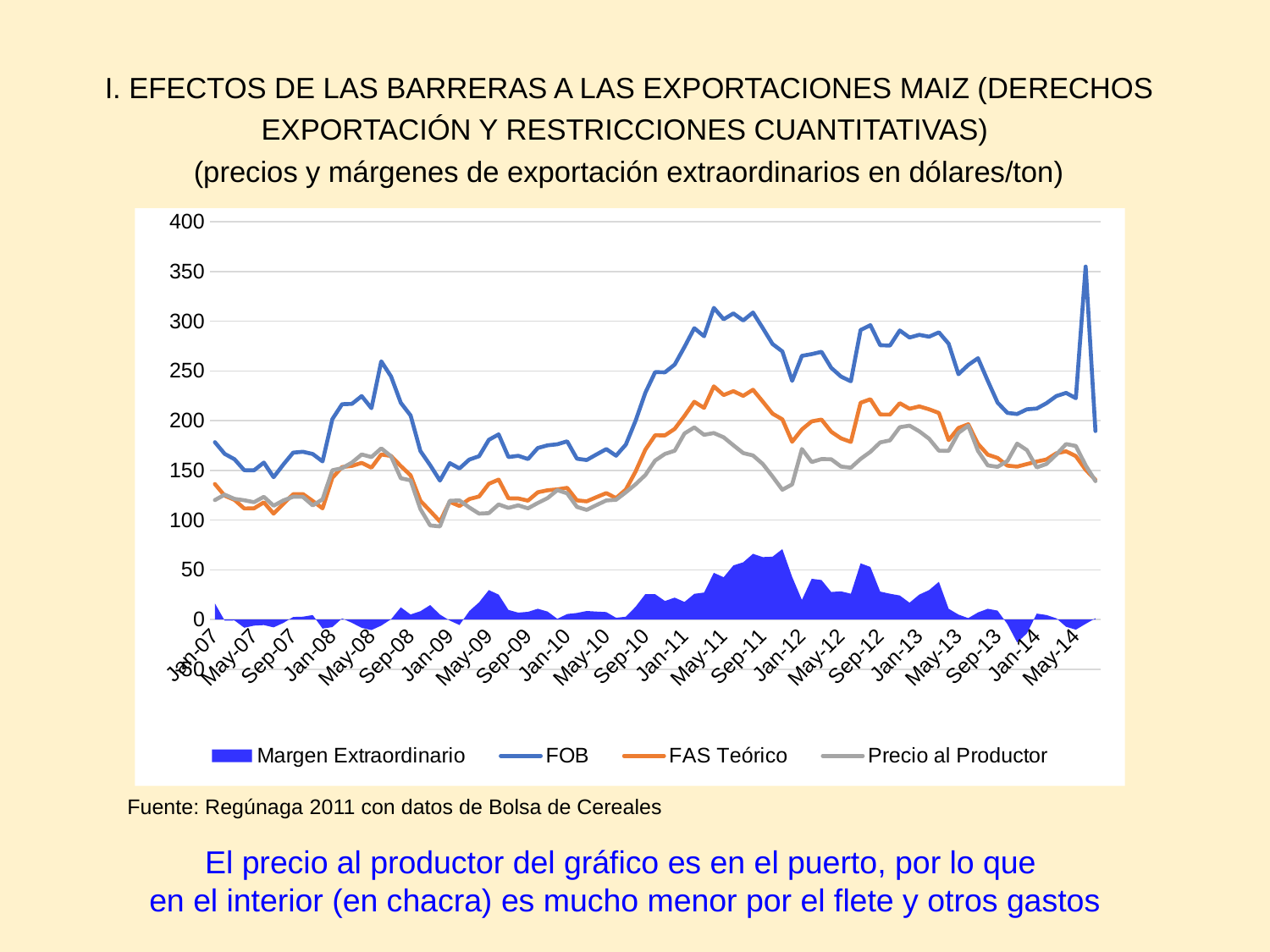
What is the highest value shown on the vertical axis? 400 Is the FOB value at Jan-07 greater or less than 150? greater What kind of chart is shown on the slide? combination area and line chart How many series does the chart legend list? 4 Which of the three price lines (FOB, FAS Teórico, Precio al Productor) is the highest across the whole period? FOB Is the FAS Teórico value at Jan-07 greater or less than 100? greater At Jan-11, which is higher: FOB or Precio al Productor? FOB Is the Precio al Productor value at Jan-09 greater or less than 100? greater Does the FOB line rise or fall overall from Sep-12 to Sep-13? fall Which series is plotted as a filled blue area rather than a line? Margen Extraordinario